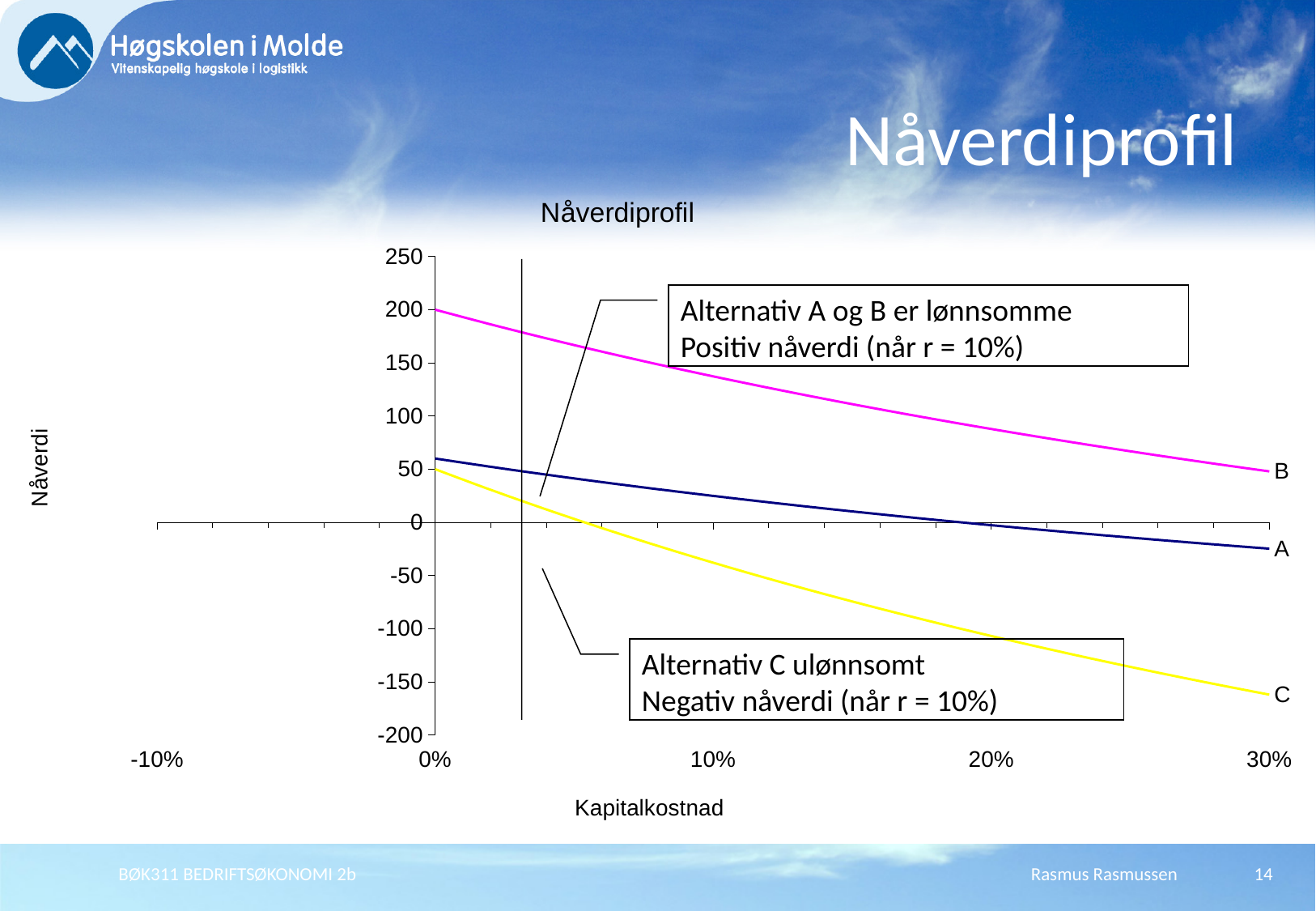
Which line has the highest Nåverdi at a Kapitalkostnad of 0%? B What is the title of the chart? Nåverdiprofil Is the value of line A at a Kapitalkostnad of 30% greater or less than 0? less Is the value of line C at a Kapitalkostnad of 20% greater or less than -50? less What kind of chart is shown on the slide? line chart How many lines (alternatives) are plotted in the Nåverdiprofil chart? 3 Is the value of line B at a Kapitalkostnad of 10% greater or less than 100? greater Which line has the lowest Nåverdi at a Kapitalkostnad of 30%? C What is the label of the x axis? Kapitalkostnad Do the values of line B rise or fall as Kapitalkostnad increases? fall At a Kapitalkostnad of 10%, which line has the larger Nåverdi, A or C? A